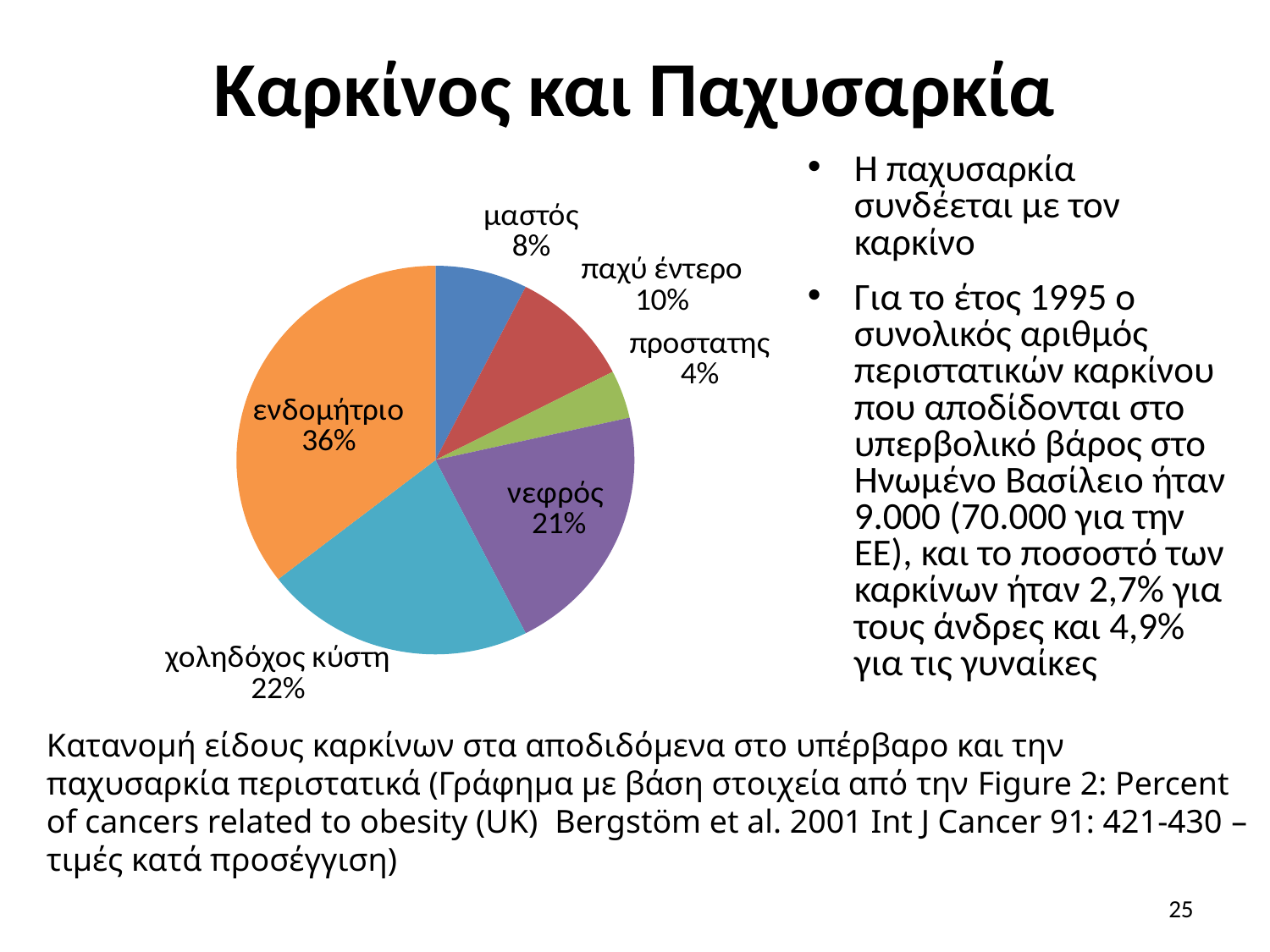
What percentage does the pie chart show for μαστός? 8% Which category has the largest slice in the pie chart? ενδομήτριο Which is larger in the pie chart, παχύ έντερο or μαστός? παχύ έντερο What percentage does the pie chart show for ενδομήτριο? 36% Which category has the smallest slice in the pie chart? προστατης What percentage does the pie chart show for προστατης? 4% What percentage does the pie chart show for νεφρός? 21% What colour is the ενδομήτριο slice in the pie chart? orange What is the combined share of νεφρός and χοληδόχος κύστη in the pie chart? 43% How many slices does the pie chart have? 6 What is the difference in percentage points between ενδομήτριο and χοληδόχος κύστη? 14 What kind of chart is shown on the slide? pie chart